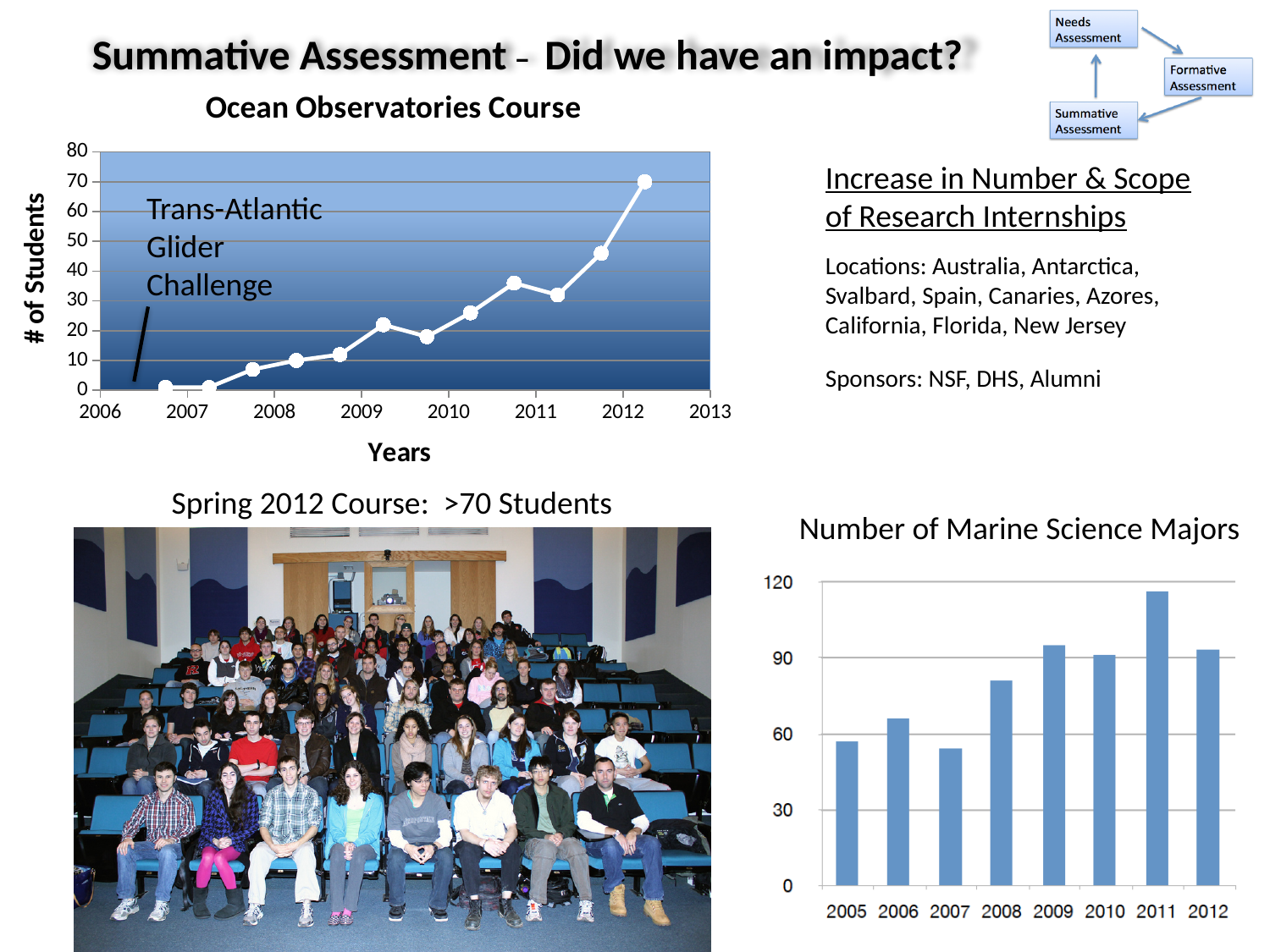
In the "Number of Marine Science Majors" chart, is the value for 2011 greater or less than 90? greater In the "Number of Marine Science Majors" chart, which is larger, the value for 2008 or the value for 2009? 2009 What type of chart is the "Number of Marine Science Majors" chart? bar chart In the "Number of Marine Science Majors" chart, is the value for 2007 greater or less than 60? less In the "Ocean Observatories Course" chart, how many data points are plotted? 12 In the "Number of Marine Science Majors" chart, is the value for 2008 greater or less than 90? less In the "Ocean Observatories Course" chart, do the number of students generally rise or fall from 2006 to 2013? rise What type of chart is the "Ocean Observatories Course" chart? line chart In the "Number of Marine Science Majors" chart, how many years are shown on the x axis? 8 In the "Number of Marine Science Majors" chart, which year has the highest number of majors? 2011 What is the y-axis label of the "Ocean Observatories Course" chart? # of Students